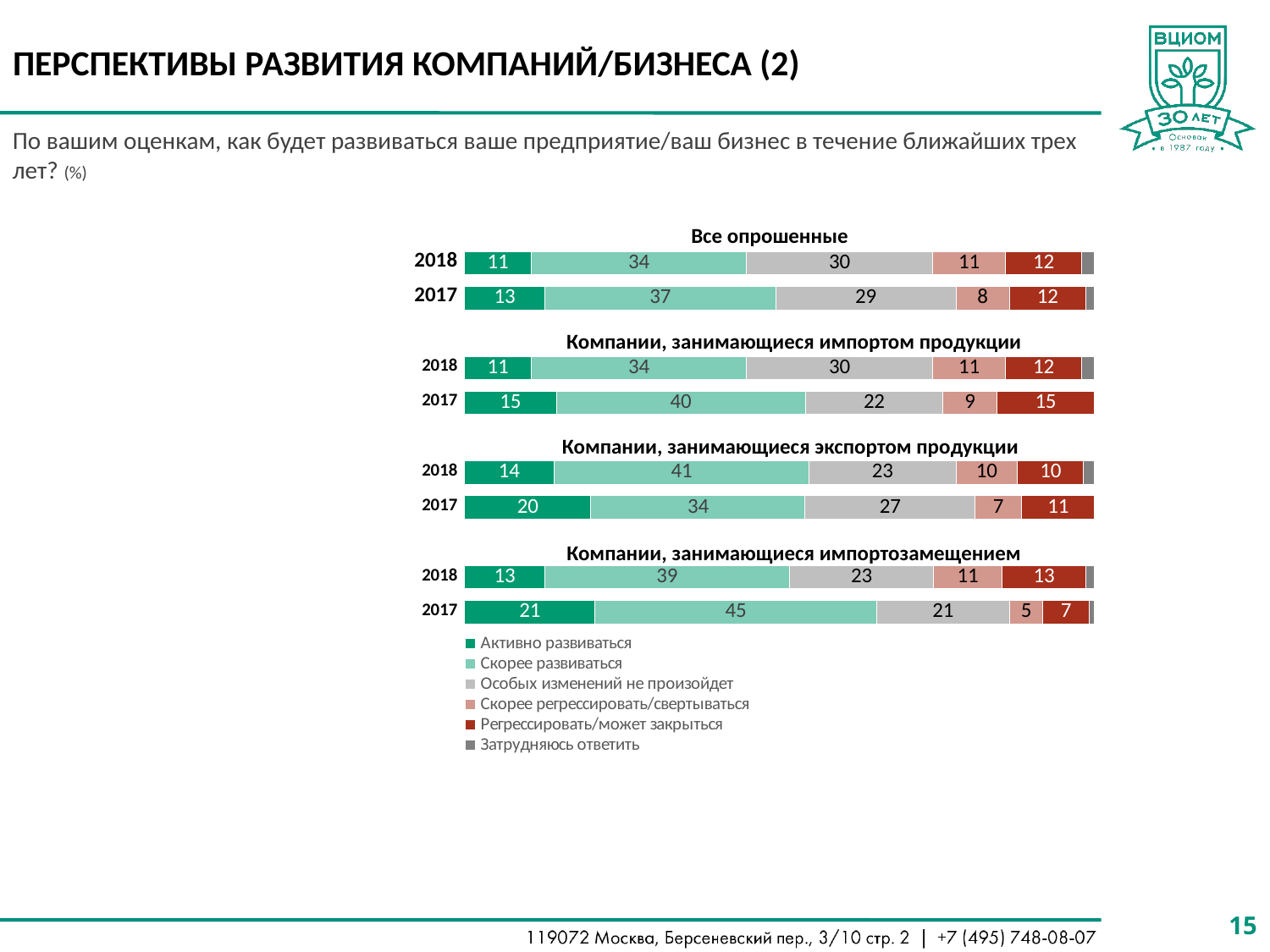
What kind of chart is used in the chart titled "Все опрошенные"? Stacked bar chart In the chart titled "Компании, занимающиеся экспортом продукции", which year has the larger value for "Активно развиваться", 2018 or 2017? 2017 In the chart titled "Компании, занимающиеся импортозамещением", what is the difference between the "Скорее развиваться" values for 2017 and 2018? 6 In the chart titled "Все опрошенные", what is the value for "Активно развиваться" in 2018? 11 In the chart titled "Компании, занимающиеся экспортом продукции", what is the value for "Скорее развиваться" in 2018? 41 In the chart titled "Компании, занимающиеся импортом продукции", what is the value for "Регрессировать/может закрыться" in 2017? 15 In the chart titled "Компании, занимающиеся импортозамещением", which labelled segment has the lowest value in the 2017 bar? Скорее регрессировать/свертываться In the chart titled "Все опрошенные", what is the value for "Скорее развиваться" in 2017? 37 How many series does the legend list for the charts on the slide? 6 In the chart titled "Компании, занимающиеся импортозамещением", what is the value for "Активно развиваться" in 2017? 21 How many bars (years) are shown in the chart titled "Компании, занимающиеся экспортом продукции"? 2 In the chart titled "Компании, занимающиеся импортом продукции", which segment has the highest value in the 2017 bar? Скорее развиваться